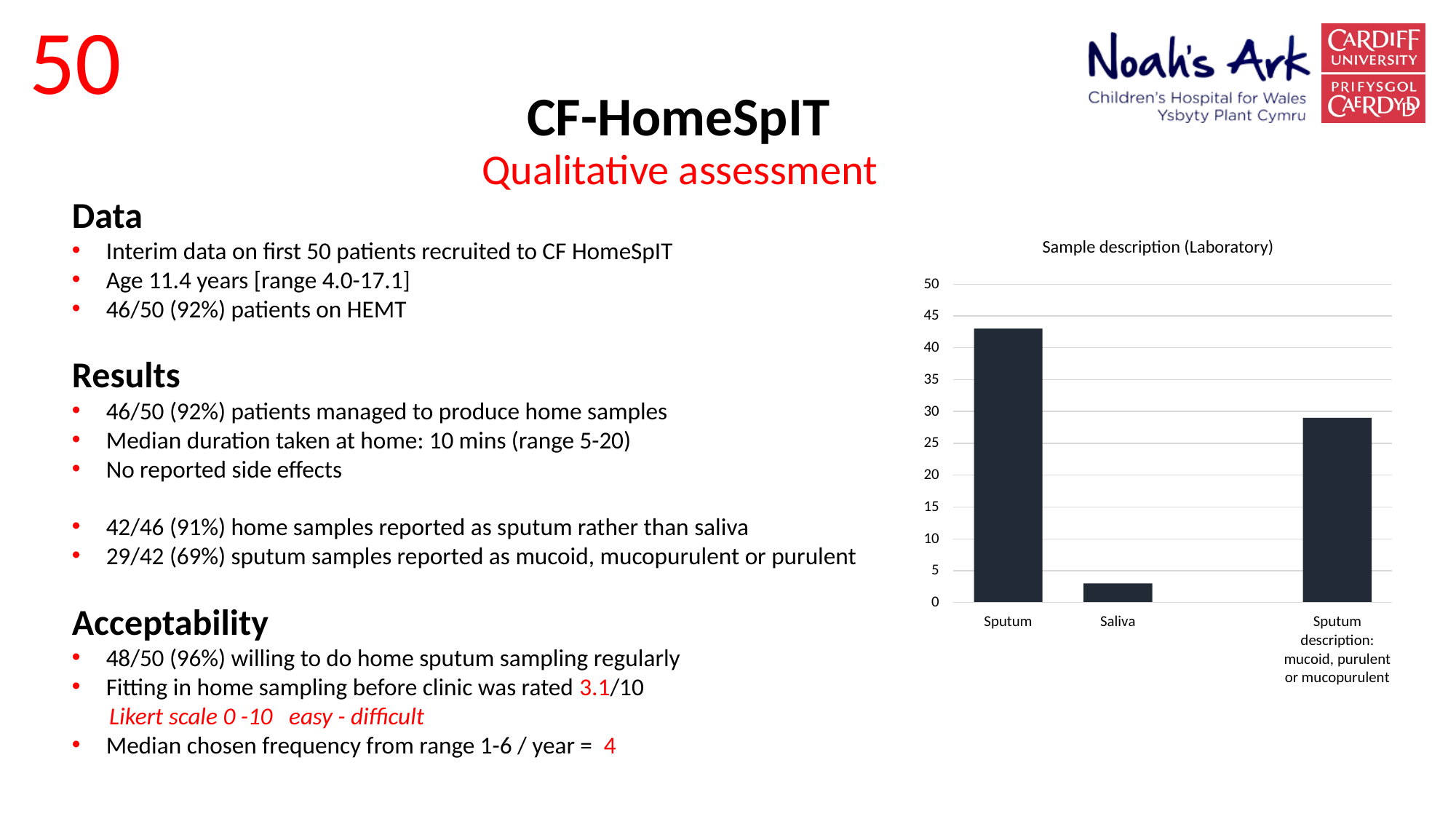
How many categories are shown on the x axis of the chart? 3 Which category has the highest bar in the chart? Sputum Is the value for Sputum greater or less than 40? greater Is the value for 'Sputum description: mucoid, purulent or mucopurulent' greater or less than 25? greater What type of chart is shown on the slide? bar chart What is the maximum value shown on the chart's y axis? 50 Which category has the lowest bar in the chart? Saliva Which is larger, the value for Sputum or the value for Saliva? Sputum Which is larger, the value for Saliva or the value for 'Sputum description: mucoid, purulent or mucopurulent'? Sputum description: mucoid, purulent or mucopurulent Is the value for Saliva greater or less than 5? less What is the title of the chart? Sample description (Laboratory)